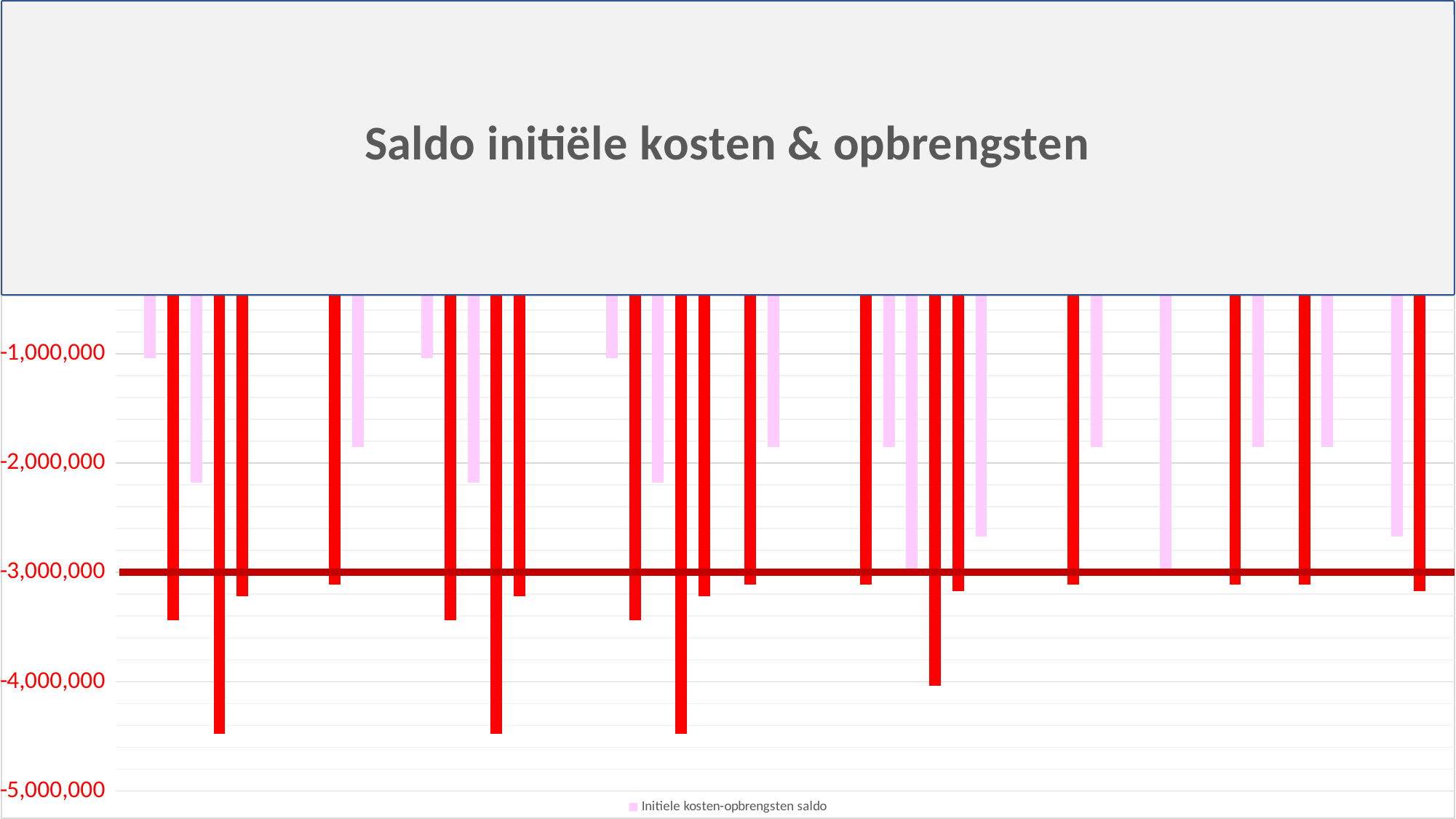
What kind of chart is shown on the slide? bar chart What is the name of the series listed in the legend? Initiele kosten-opbrengsten saldo At what value is the horizontal red line drawn across the chart? -3,000,000 Do any of the pink bars extend below -3,000,000? No What is the title of the chart? Saldo initiële kosten & opbrengsten How many series does the legend list? 1 Do the tallest red bars extend below -4,000,000? Yes